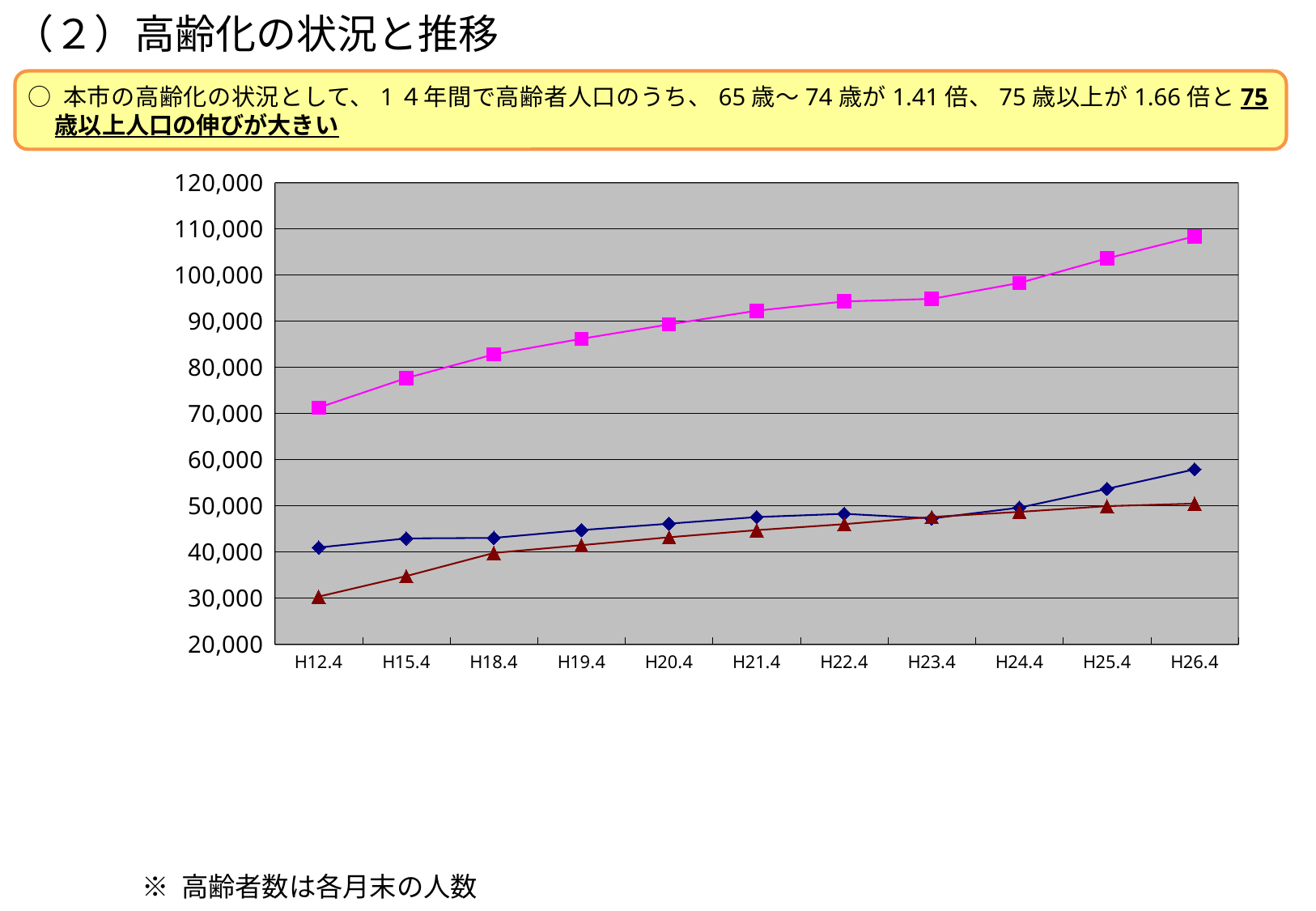
Is the value of the red triangle-marker line at H26.4 greater or less than 60,000? less What kind of chart is shown on the slide? line chart Is the value of the red triangle-marker line at H12.4 greater or less than 40,000? less At H12.4, which is larger: the blue diamond-marker line or the red triangle-marker line? blue diamond-marker line How many time points are plotted along the x axis of the chart? 11 Does the magenta line with square markers rise or fall from H12.4 to H26.4? rise What is the highest value shown on the y axis of the chart? 120,000 At which time point does the magenta square-marker line reach its highest value? H26.4 At which time point is the red triangle-marker line at its lowest value? H12.4 Is the value of the magenta square-marker line at H26.4 greater or less than 100,000? greater At H26.4, which is larger: the blue diamond-marker line or the red triangle-marker line? blue diamond-marker line